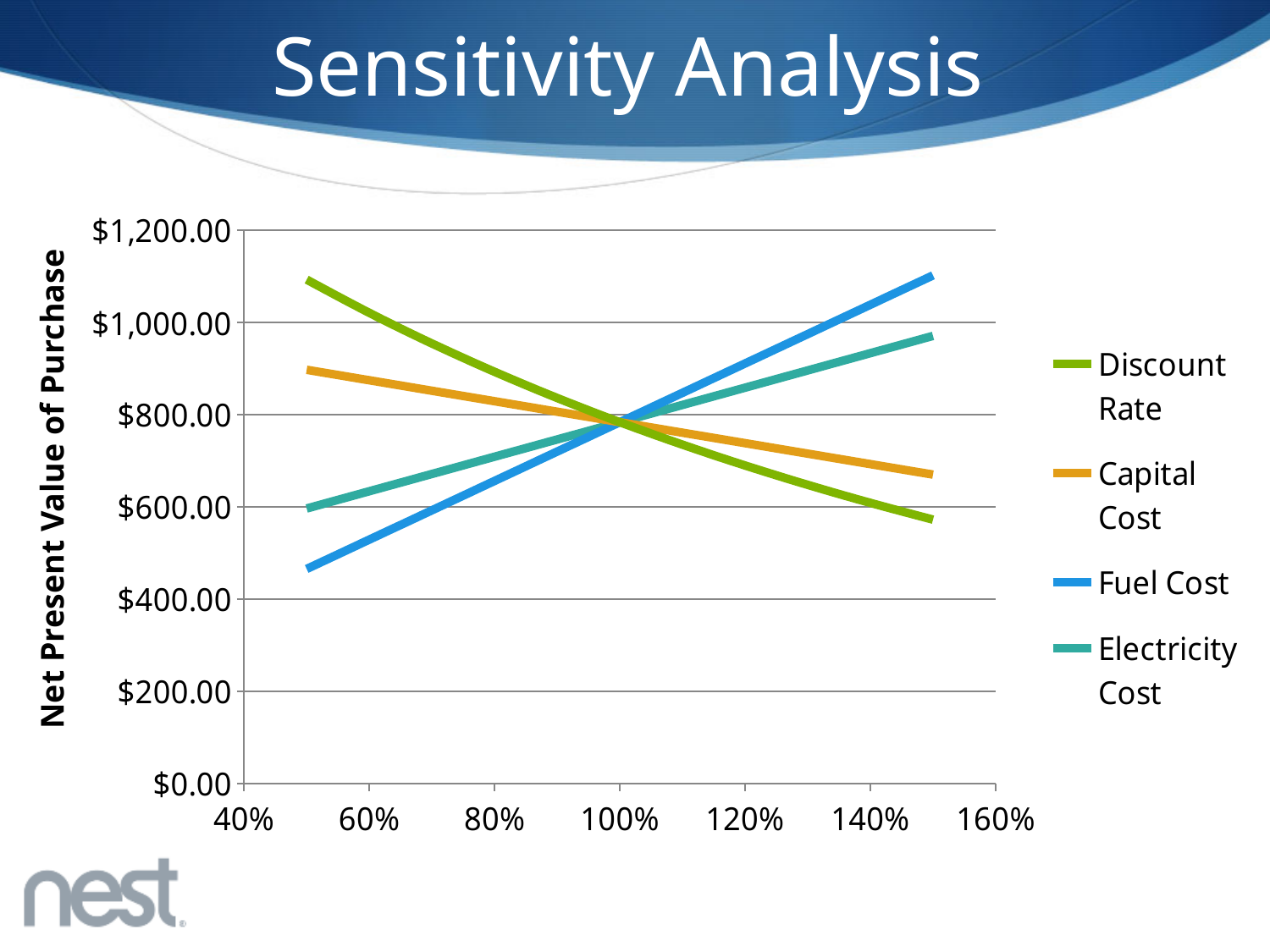
How many series does the legend list? 4 What is the title of the vertical axis? Net Present Value of Purchase Which series has the lowest value at 50%? Fuel Cost Does the Capital Cost line rise or fall as the x-axis percentage increases? falls Is the Fuel Cost value at 150% greater or less than $1,000.00? greater Is the Fuel Cost value at 50% greater or less than $600.00? less What kind of chart is shown on the slide? line chart Does the Discount Rate line rise or fall as the x-axis percentage increases? falls Does the Electricity Cost line rise or fall as the x-axis percentage increases? rises Which series has the highest value at 150%? Fuel Cost Is the Discount Rate value at 50% greater or less than $1,000.00? greater